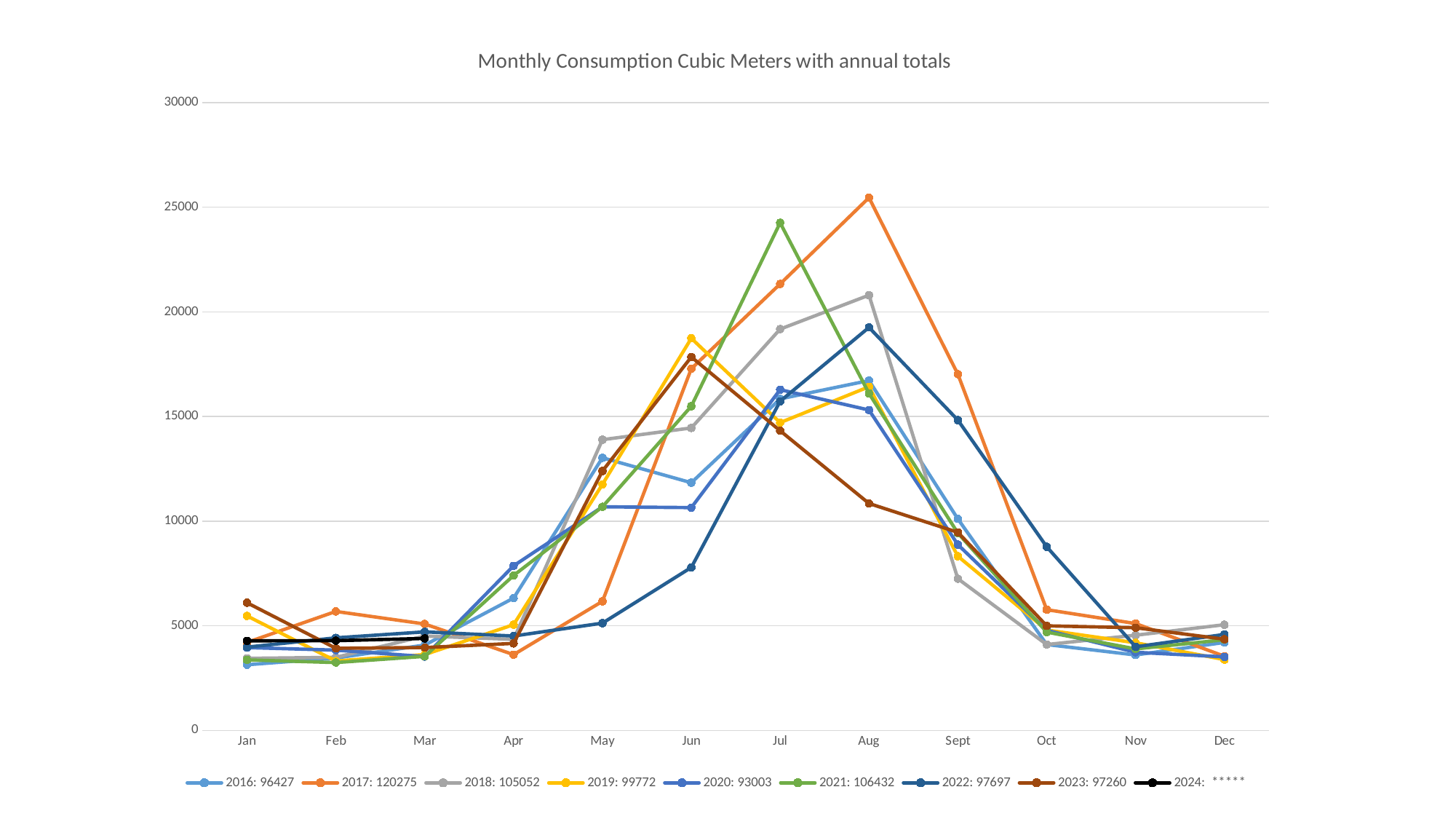
What annual total does the legend give for 2017? 120275 Is the value for 2017 in Aug greater or less than 25000? greater Which year has the lowest annual total shown in the legend (excluding 2024, which has no total)? 2020 What kind of chart is shown on the slide? line chart How many series does the legend list? 9 What is the difference between the annual totals for 2017 and 2020 shown in the legend? 27272 Which annual total is larger in the legend, 2018 or 2021? 2021 Which year has the highest annual total shown in the legend? 2017 What is the title of the chart? Monthly Consumption Cubic Meters with annual totals Is the value for 2023 in Aug greater or less than 15000? less How many months are shown along the x axis? 12 What annual total does the legend give for 2020? 93003